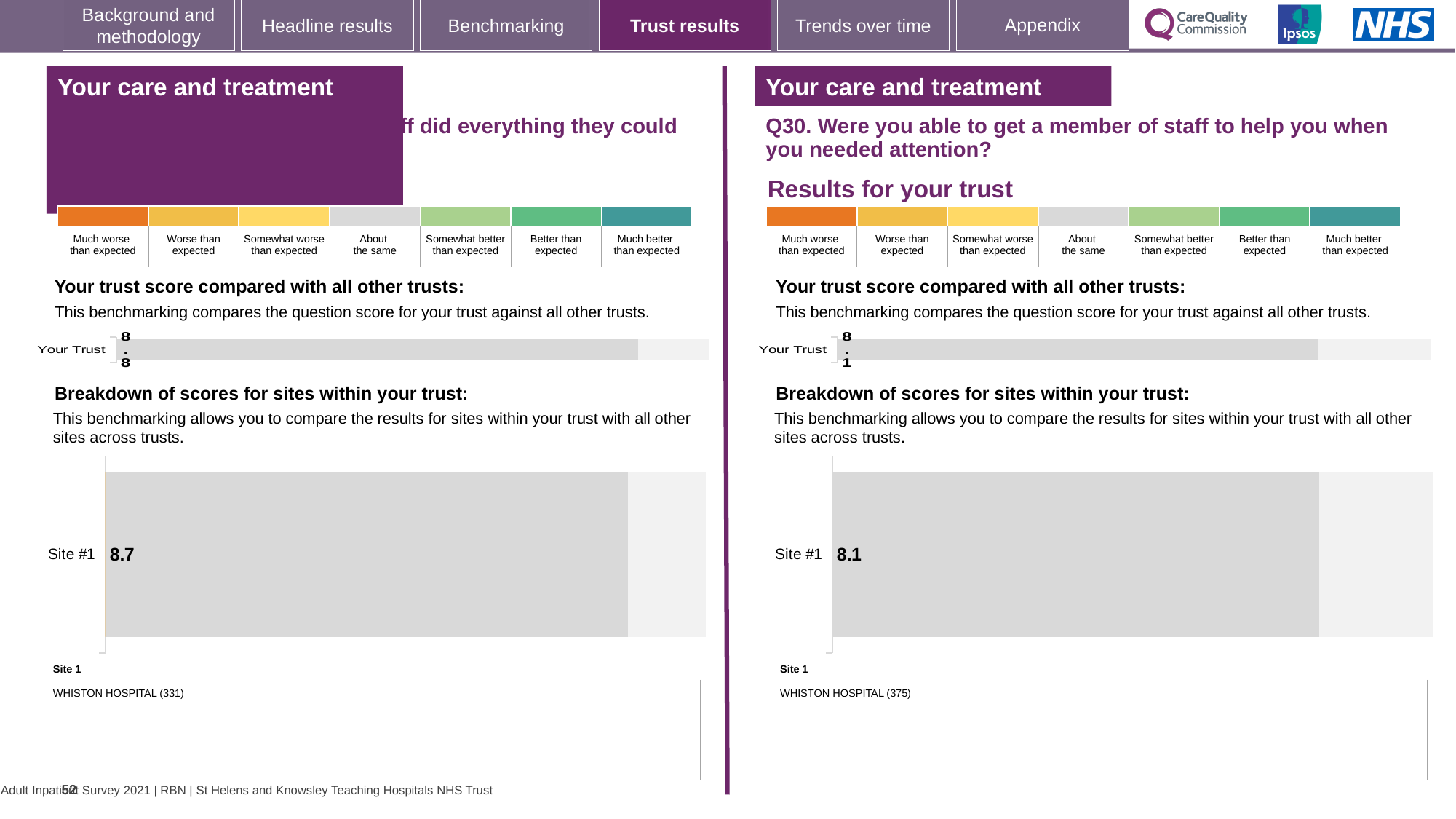
On the left-hand 'Your trust score compared with all other trusts' chart, what is the score for Your Trust? 8.8 On the right-hand 'Your trust score compared with all other trusts' chart (Q30), what is the score for Your Trust? 8.1 On the left-hand 'Breakdown of scores for sites within your trust' chart, what is the score for Site #1? 8.7 What is the difference between the Site #1 score on the left-hand breakdown chart and the Site #1 score on the right-hand breakdown chart? 0.6 What is the difference between the Your Trust score on the left-hand chart and the Your Trust score on the right-hand chart? 0.7 Which is larger on the right-hand side: the Your Trust score or the Site #1 score? They are equal (8.1) On the right-hand 'Breakdown of scores for sites within your trust' chart (Q30), what is the score for Site #1? 8.1 Which is larger: the Site #1 score on the left-hand breakdown chart or the Site #1 score on the right-hand breakdown chart? Left-hand (8.7) On the right-hand breakdown chart, which hospital is listed as Site 1? WHISTON HOSPITAL (375) On the left-hand breakdown chart, which hospital is listed as Site 1? WHISTON HOSPITAL (331) How many sites are shown on the left-hand 'Breakdown of scores for sites within your trust' chart? 1 What type of chart is used to show the Site #1 score on the right-hand breakdown chart? Bar chart